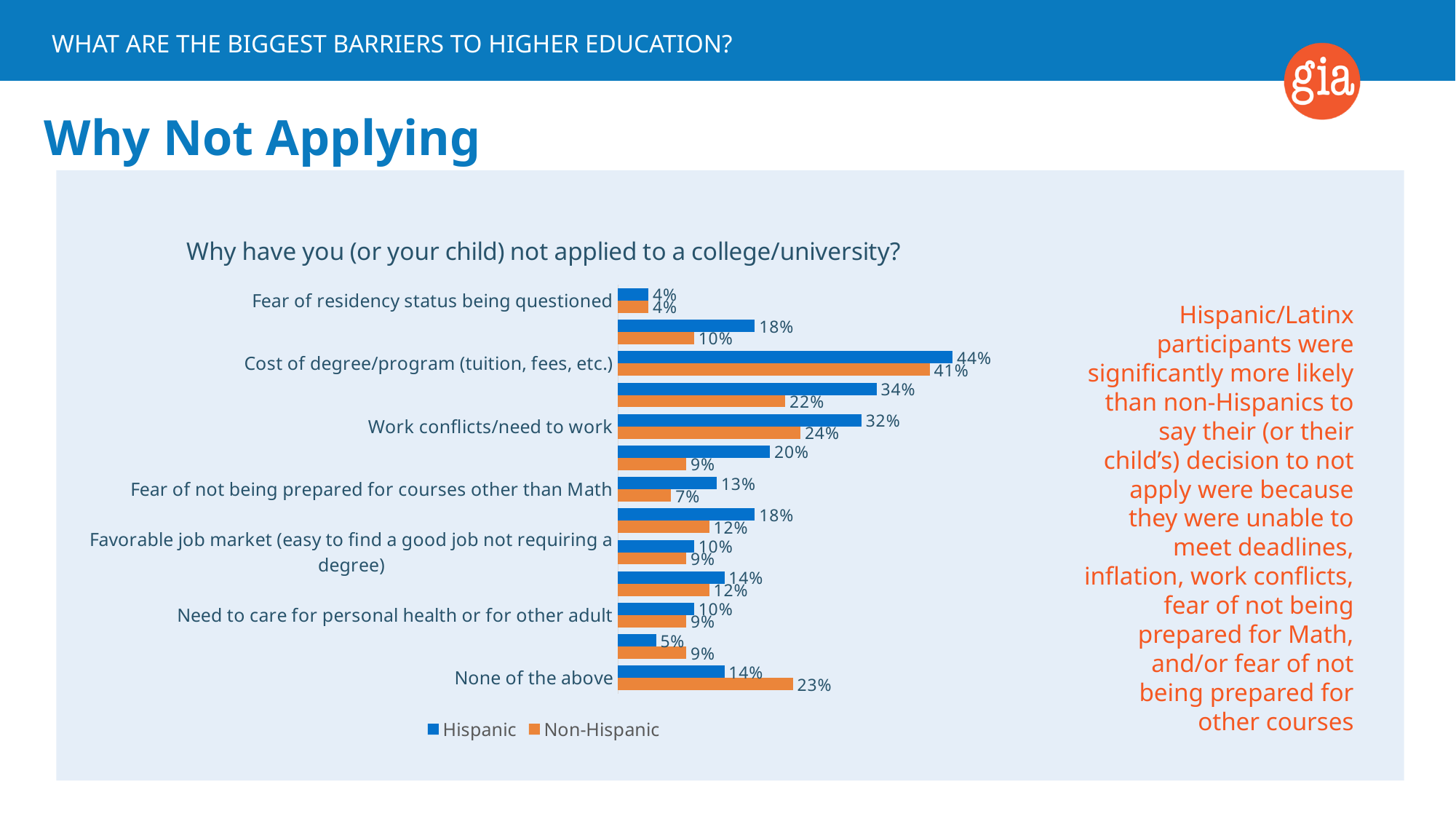
Which category has the lowest Non-Hispanic value? Fear of residency status being questioned How many series does the legend list? 2 What is the Non-Hispanic value for 'Work conflicts/need to work'? 24% What is the Non-Hispanic value for 'None of the above'? 23% What is the difference between the Hispanic and Non-Hispanic values for 'Work conflicts/need to work'? 8% What is the difference between the Hispanic and Non-Hispanic values for 'Fear of not being prepared for courses other than Math'? 6% What kind of chart is shown on the slide? bar chart What is the Hispanic value for 'Fear of not being prepared for courses other than Math'? 13% What is the Hispanic value for 'Cost of degree/program (tuition, fees, etc.)'? 44% Which category has the highest Hispanic value? Cost of degree/program (tuition, fees, etc.) What colour represents the Non-Hispanic series in the chart? orange For 'None of the above', which series has the larger value, Hispanic or Non-Hispanic? Non-Hispanic